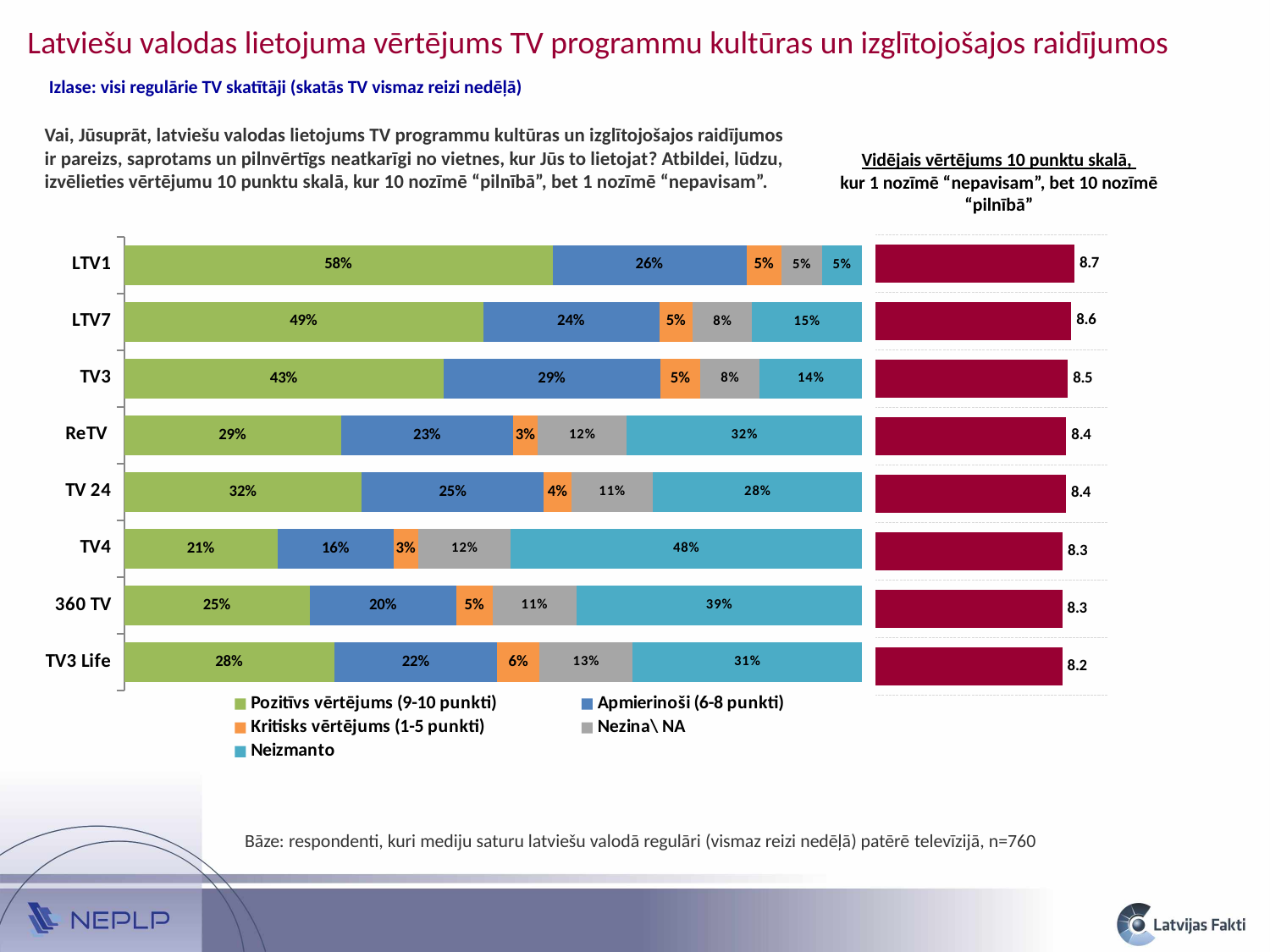
How many TV channels are listed in the stacked bar chart on the left? 8 In the stacked bar chart on the left, what is the "Nezina\ NA" share for ReTV? 12% In the "Vidējais vērtējums 10 punktu skalā" chart on the right, what is the average rating for LTV1? 8.7 In the stacked bar chart on the left, which channel has the larger "Neizmanto" share, 360 TV or TV3 Life? 360 TV In the stacked bar chart on the left, what is the "Neizmanto" share for TV4? 48% What kind of chart is the chart on the left of the slide? Stacked bar chart In the stacked bar chart on the left, what is the difference in percentage points between the "Pozitīvs vērtējums (9-10 punkti)" shares of LTV1 and LTV7? 9 percentage points How many series does the legend of the stacked bar chart on the left list? 5 In the "Vidējais vērtējums 10 punktu skalā" chart on the right, which channel has the lowest average rating? TV3 Life In the stacked bar chart on the left, what is the "Pozitīvs vērtējums (9-10 punkti)" share for LTV1? 58% In the stacked bar chart on the left, which channel has the lowest "Pozitīvs vērtējums (9-10 punkti)" share? TV4 In the stacked bar chart on the left, which channel has the highest "Pozitīvs vērtējums (9-10 punkti)" share? LTV1